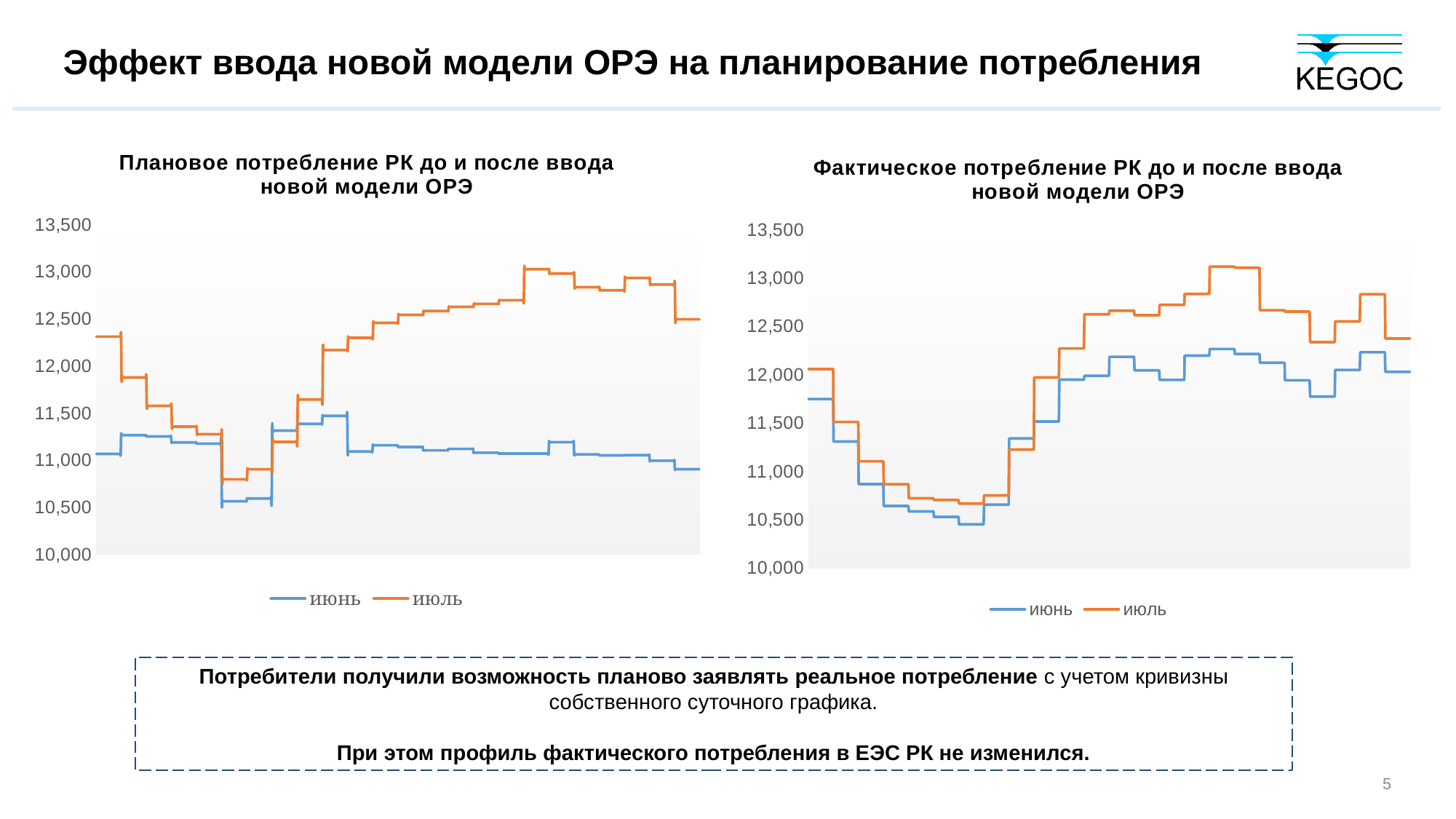
In the right chart 'Фактическое потребление РК до и после ввода новой модели ОРЭ', which series reaches the higher peak, июнь or июль? июль What are the legend entries of the right chart 'Фактическое потребление РК до и после ввода новой модели ОРЭ'? июнь, июль In the left chart 'Плановое потребление РК до и после ввода новой модели ОРЭ', is the lowest value of the июнь series greater or less than 11,000? less In the left chart 'Плановое потребление РК до и после ввода новой модели ОРЭ', is the highest value of the июнь series greater or less than 12,000? less In the right chart 'Фактическое потребление РК до и после ввода новой модели ОРЭ', is the lowest value of the июнь series greater or less than 11,000? less What is the title of the right chart on the slide? Фактическое потребление РК до и после ввода новой модели ОРЭ How many series does the legend of the left chart 'Плановое потребление РК до и после ввода новой модели ОРЭ' list? 2 In the left chart 'Плановое потребление РК до и после ввода новой модели ОРЭ', which series is higher at the right end of the x axis, июнь or июль? июль What kind of chart is the left chart, 'Плановое потребление РК до и после ввода новой модели ОРЭ'? line chart